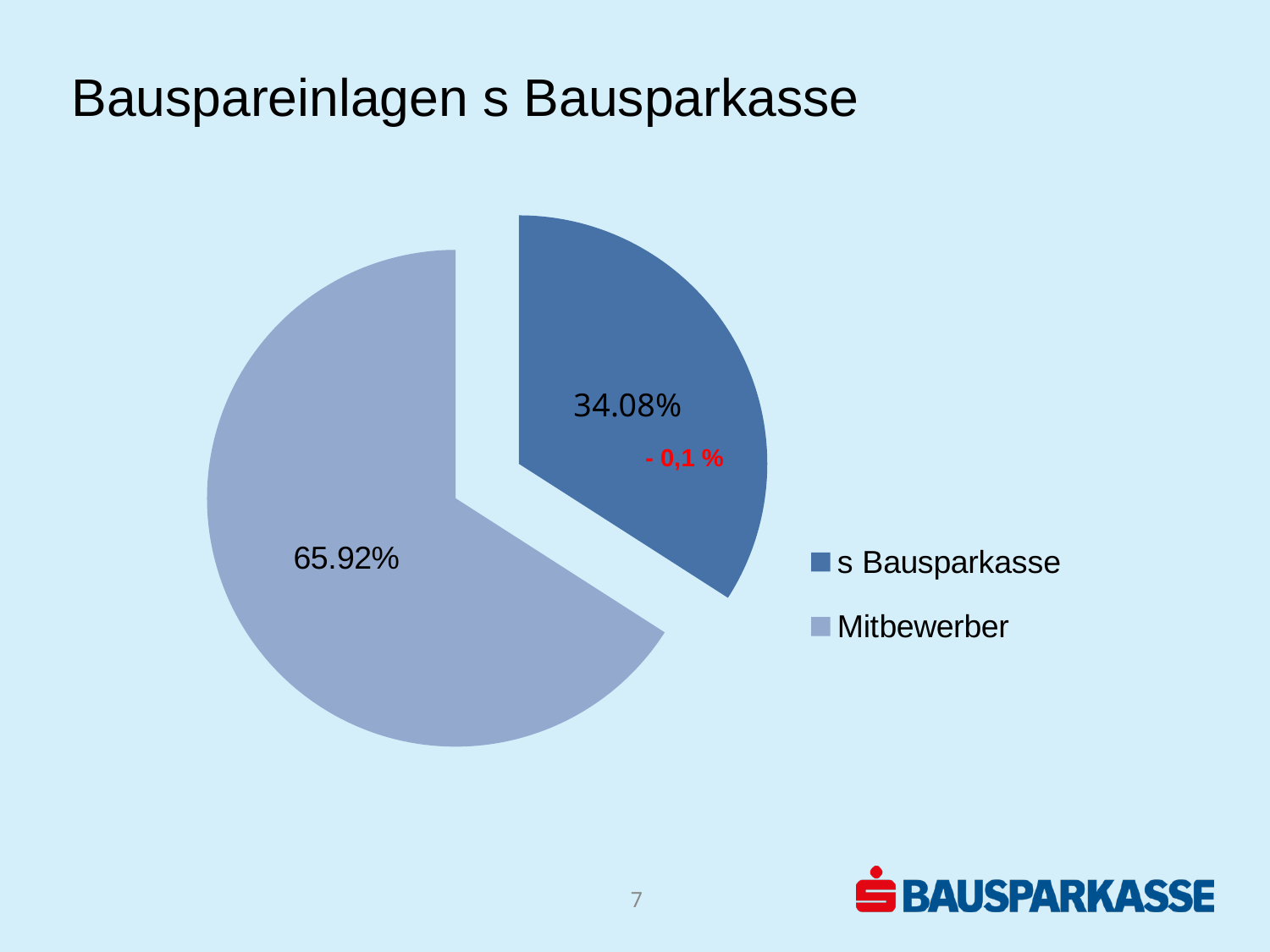
How many slices does the pie chart have? 2 What share of the pie does s Bausparkasse hold? 34.08% What is the title of the slide? Bauspareinlagen s Bausparkasse What is the difference in percentage points between the Mitbewerber and s Bausparkasse slices? 31.84 What kind of chart is shown on the slide? Pie chart What change is annotated in red next to the s Bausparkasse slice? - 0,1 % What share of the pie does Mitbewerber hold? 65.92% Which slice is the smallest? s Bausparkasse Which slice is the largest? Mitbewerber Is the share for s Bausparkasse greater or less than 50%? less Which is larger, the s Bausparkasse slice or the Mitbewerber slice? Mitbewerber How many entries does the legend list? 2